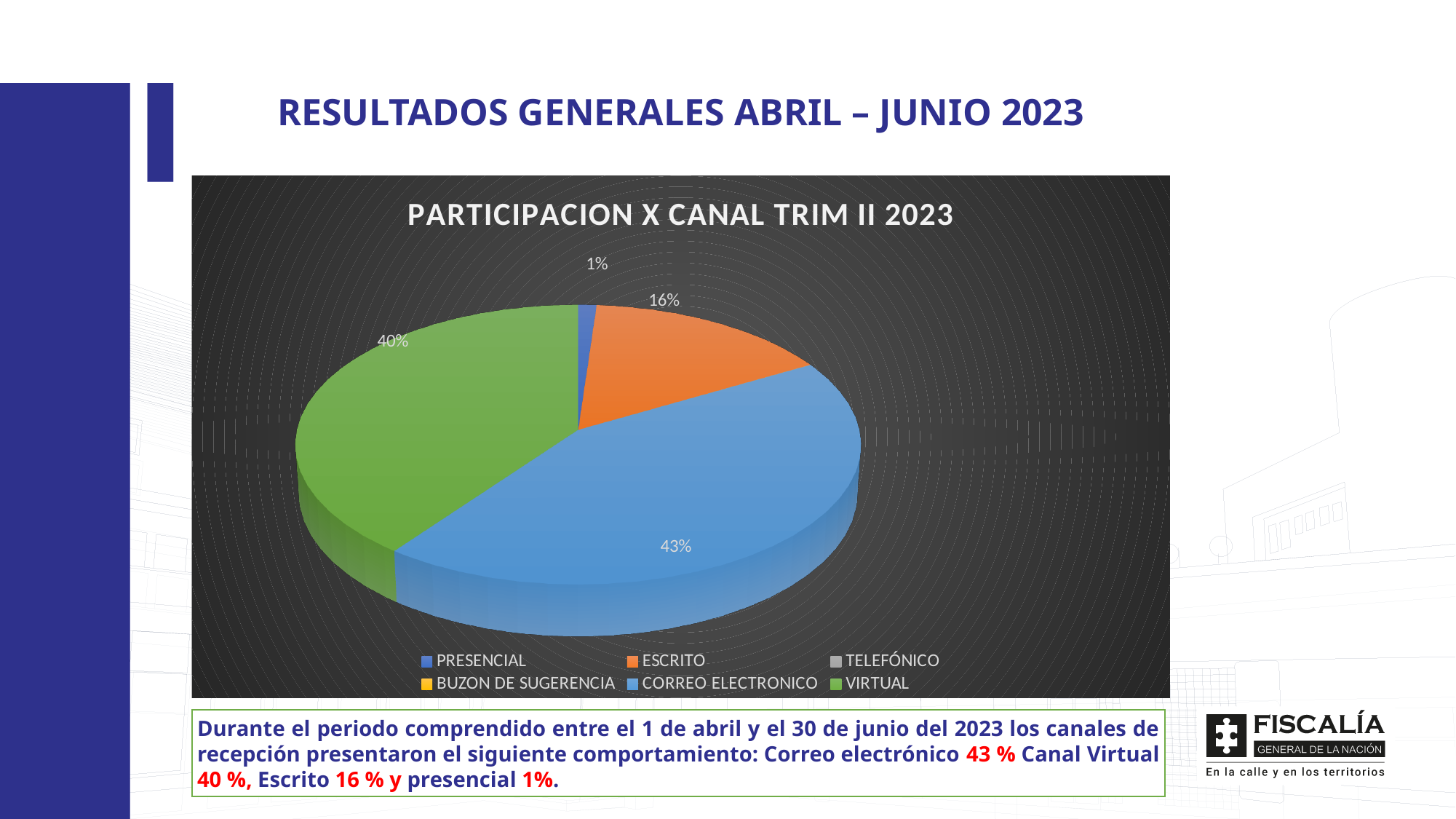
How many entries does the chart legend list? 6 What is the difference in percentage points between ESCRITO and PRESENCIAL? 15 Which is larger, the share for ESCRITO or the share for VIRTUAL? VIRTUAL What is the difference in percentage points between CORREO ELECTRONICO and VIRTUAL? 3 Which channel with a labelled slice has the smallest share of the pie? PRESENCIAL What kind of chart is shown on the slide? Pie chart What is the title of the chart? PARTICIPACION X CANAL TRIM II 2023 What percentage is shown for the PRESENCIAL channel? 1% Which channel has the largest share of the pie? CORREO ELECTRONICO What percentage is shown for the VIRTUAL channel? 40% What percentage is shown for the ESCRITO channel? 16% What share of the pie does CORREO ELECTRONICO represent? 43%